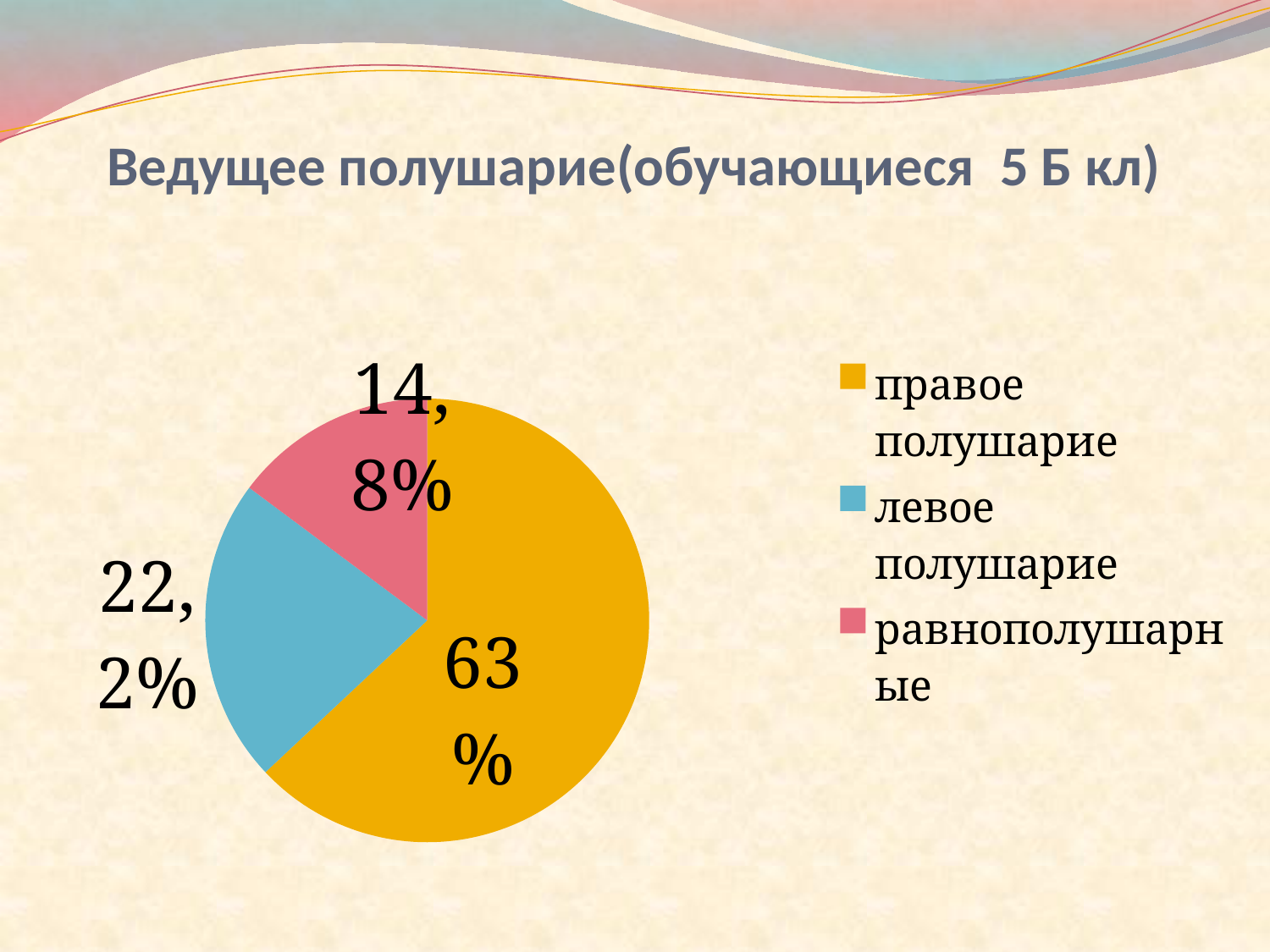
Which category has the smallest share of the pie? равнополушарные How many slices does the pie chart have? 3 Which category has the largest share of the pie? правое полушарие What percentage is shown for левое полушарие? 22,2% What percentage is shown for равнополушарные? 14,8% Which is larger: the share of левое полушарие or равнополушарные? левое полушарие What is the title of the chart? Ведущее полушарие(обучающиеся 5 Б кл) What colour is the slice for равнополушарные? pink What is the difference between the shares of правое полушарие and левое полушарие? 40,8% What type of chart is shown on the slide? pie chart What percentage is shown for правое полушарие? 63% How many entries does the legend list? 3